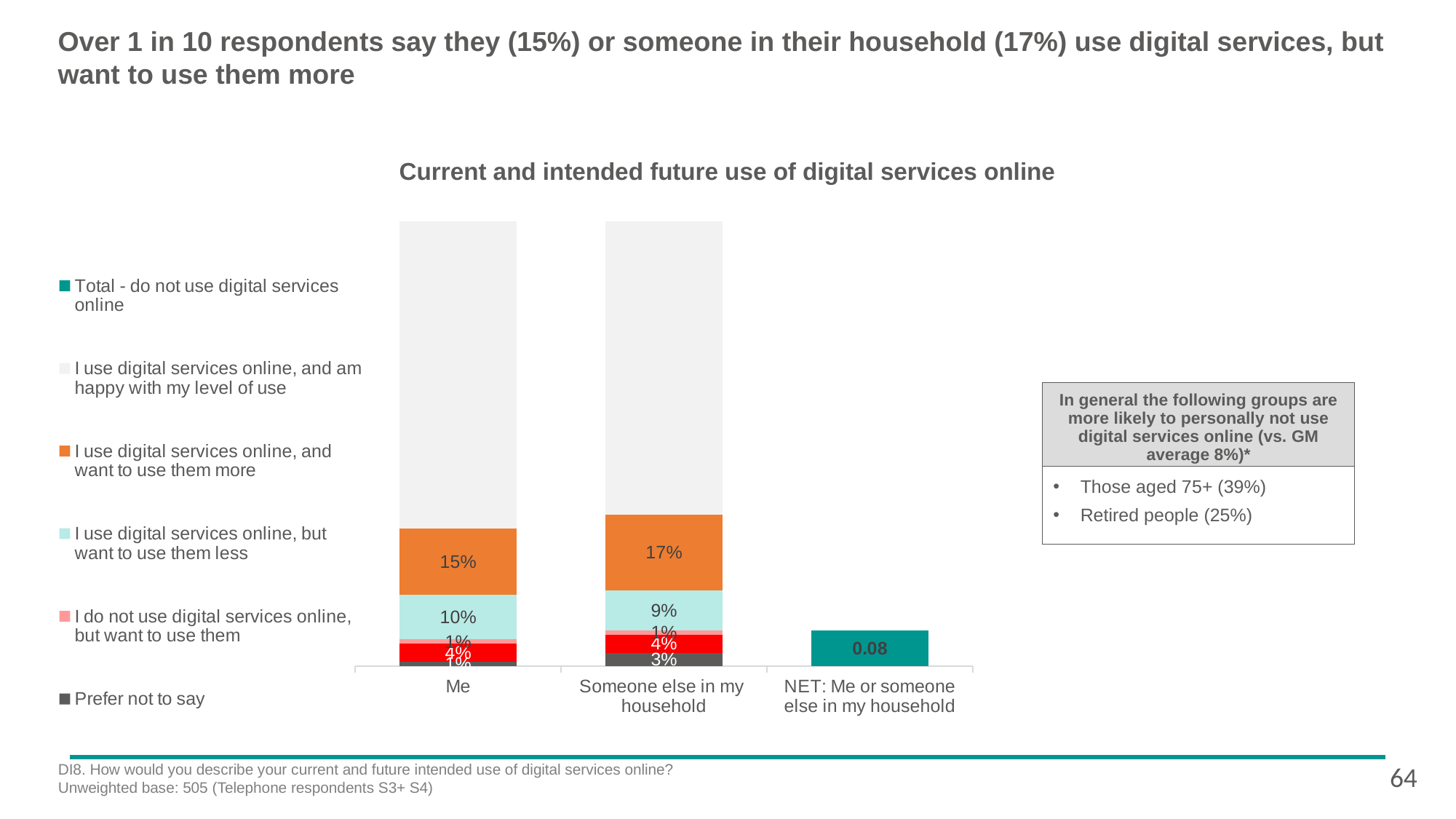
What type of chart is shown on the slide? stacked bar chart Which bar has the larger value for 'I use digital services online, but want to use them less': 'Me' or 'Someone else in my household'? Me What is the title of the chart? Current and intended future use of digital services online What is the value for 'I use digital services online, and want to use them more' for the 'Me' bar? 15% What is the value for 'Prefer not to say' for the 'Someone else in my household' bar? 3% What is the value shown for the 'NET: Me or someone else in my household' bar? 0.08 What is the value for 'I use digital services online, and want to use them more' for the 'Someone else in my household' bar? 17% What is the value for 'I use digital services online, but want to use them less' for the 'Me' bar? 10% How many categories are shown along the x axis of the chart? 3 How many series does the chart legend list? 6 What is the value for 'I use digital services online, but want to use them less' for the 'Someone else in my household' bar? 9% What is the difference between the 'want to use them more' values for 'Someone else in my household' and 'Me'? 2%